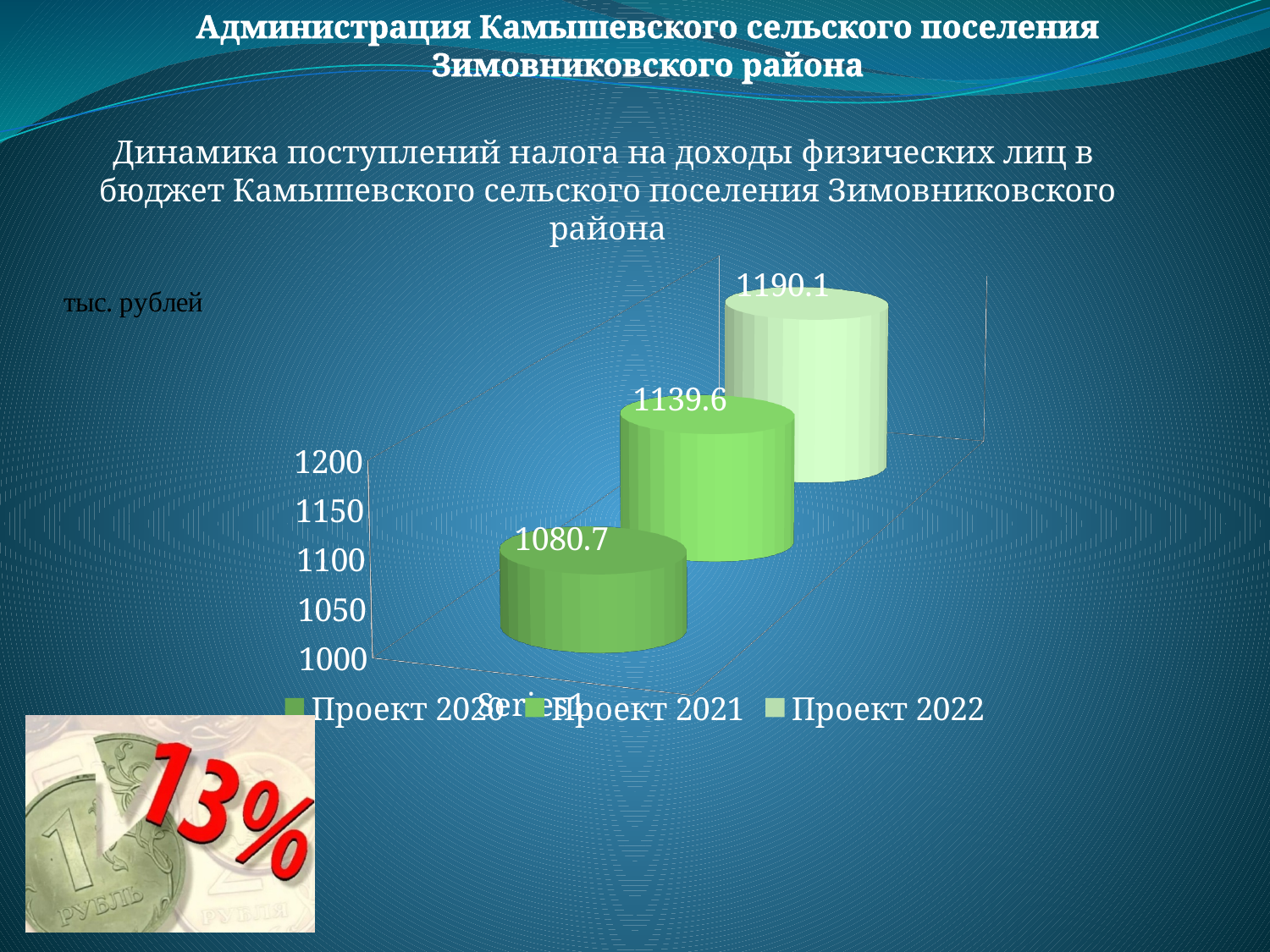
What is the value for Проект 2020? 1080.7 Which series has the highest value? Проект 2022 What kind of chart is shown on the slide? bar chart Which is larger, the value for Проект 2021 or Проект 2022? Проект 2022 Is the value for Проект 2021 greater or less than 1100? greater What is the value for Проект 2021? 1139.6 Which series has the lowest value? Проект 2020 What is the difference between the values for Проект 2022 and Проект 2020? 109.4 What is the difference between the values for Проект 2021 and Проект 2020? 58.9 How many series does the legend list? 3 What is the value for Проект 2022? 1190.1 Do the values rise or fall from Проект 2020 to Проект 2022? rise